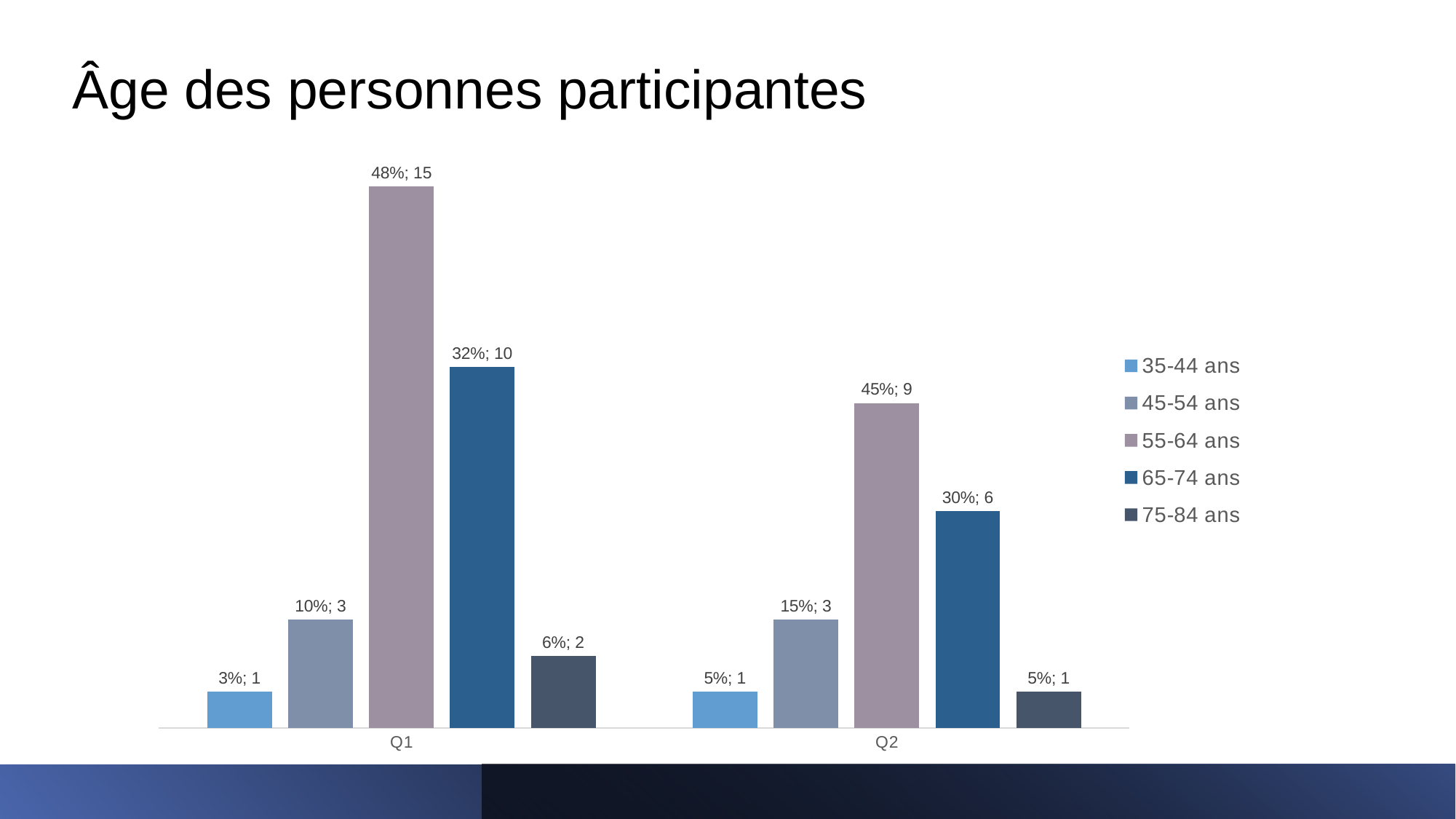
How many categories are shown on the x axis? 2 What is the difference in count between the 55-64 ans and 65-74 ans groups in Q1? 5 Which age group has the lowest value in Q1? 35-44 ans What is the data label for the 45-54 ans series in Q2? 15%; 3 What is the total count across all age groups in Q2? 20 What kind of chart is shown on the slide? Bar chart How many series does the legend list? 5 Which age group has the highest value in Q1? 55-64 ans What is the data label for the 55-64 ans series in Q1? 48%; 15 What is the data label for the 65-74 ans series in Q2? 30%; 6 What is the title of the slide? Âge des personnes participantes